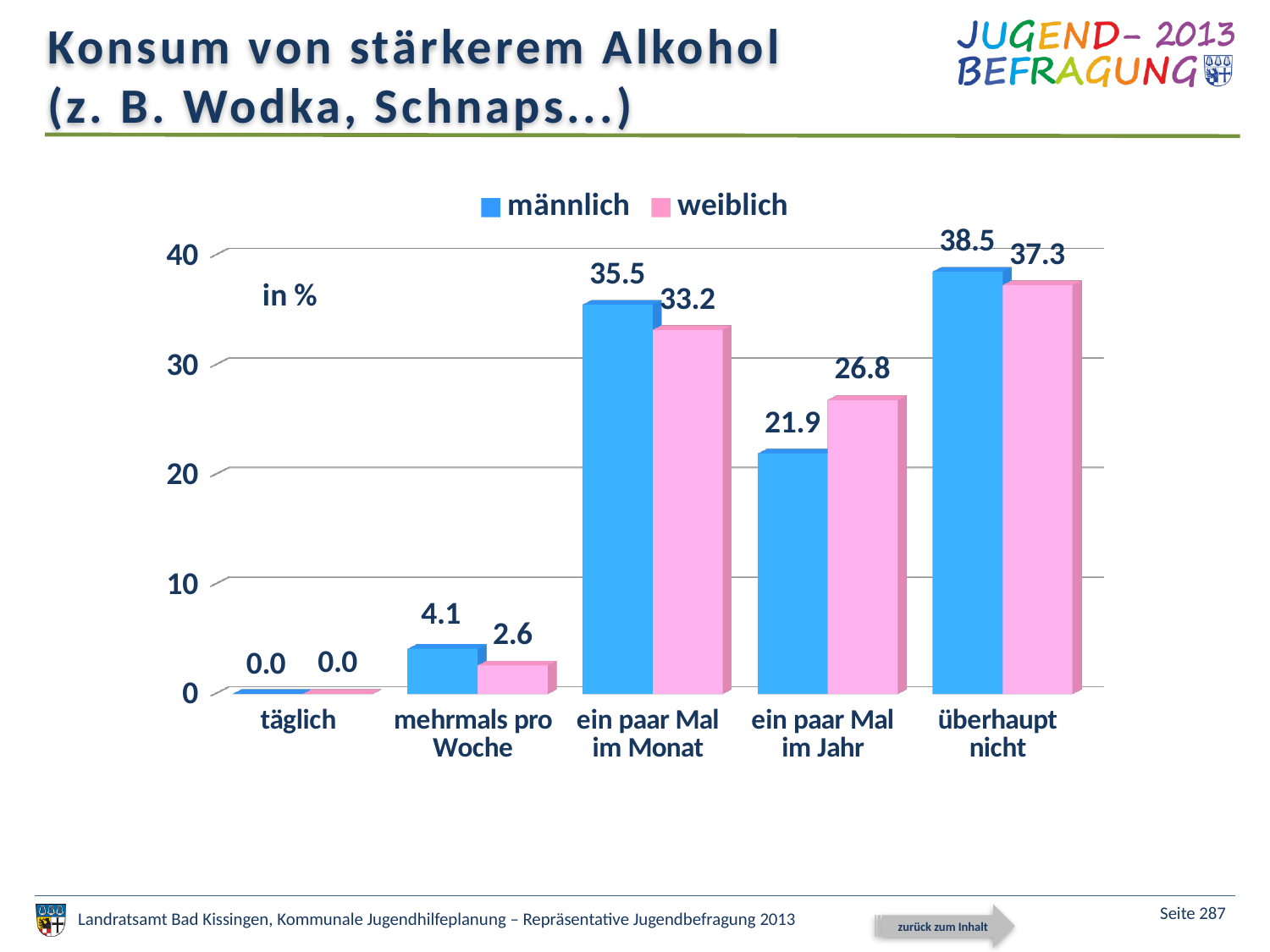
How many categories are shown on the x axis? 5 How many series does the legend list? 2 In the category 'ein paar Mal im Jahr', which series has the larger value, männlich or weiblich? weiblich Which category has the lowest value for weiblich? täglich Is the value for männlich in 'ein paar Mal im Monat' greater or less than 30? greater What is the value for männlich in the category 'ein paar Mal im Monat'? 35.5 What is the value for weiblich in the category 'ein paar Mal im Jahr'? 26.8 What unit is indicated for the values in the chart? in % Which category has the highest value for männlich? überhaupt nicht What is the value for weiblich in the category 'mehrmals pro Woche'? 2.6 What is the difference between männlich and weiblich in the category 'überhaupt nicht'? 1.2 What kind of chart is shown on the slide? bar chart